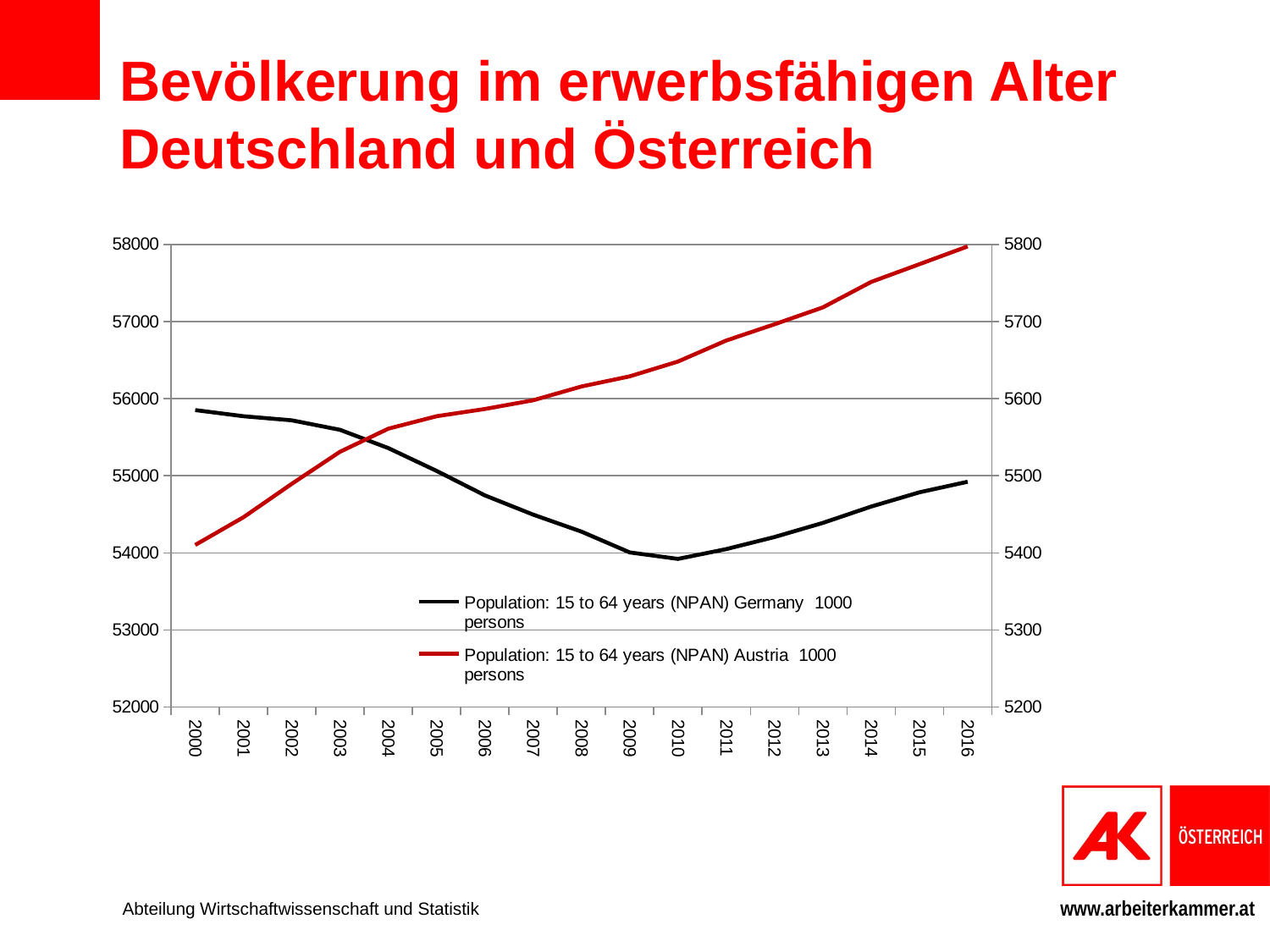
Is the value for Austria in 2008 greater or less than 5600? greater Which series is drawn in red? Population: 15 to 64 years (NPAN) Austria 1000 persons For the Germany series, which is larger: the value in 2000 or the value in 2016? 2000 How many series does the legend list? 2 Is the value for Germany in 2010 greater or less than 54000? less In which year does the Germany series reach its lowest value? 2010 In which year does the Austria series reach its highest value? 2016 How many years are plotted along the x axis? 17 Is the value for Germany in 2000 greater or less than 55000? greater What kind of chart is shown on the slide? line chart Does the Austria series rise or fall from 2000 to 2016? rise What is the title of the slide containing the chart? Bevölkerung im erwerbsfähigen Alter Deutschland und Österreich